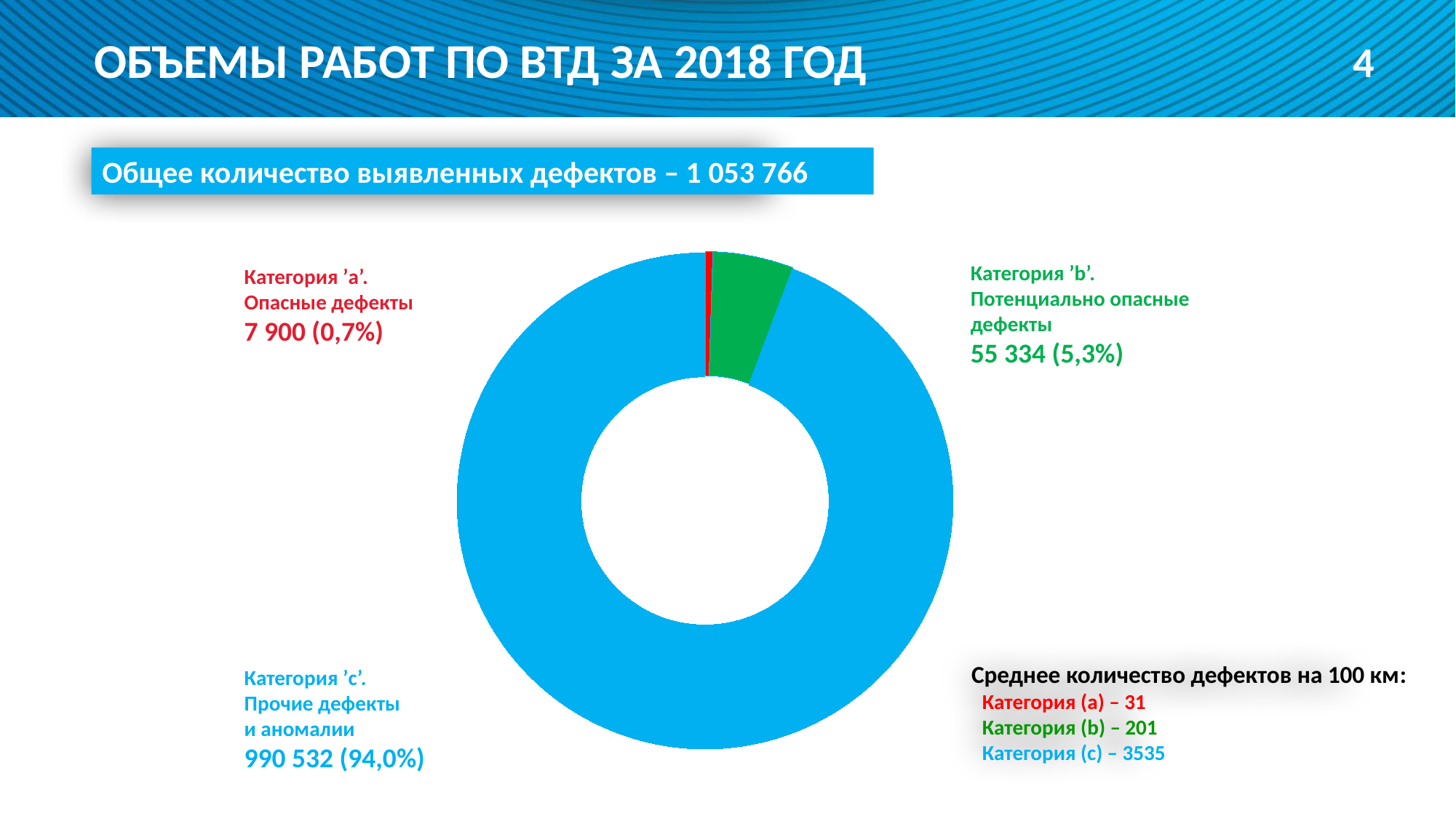
Which category has the largest slice of the chart? Категория 'c' What is the number of defects for Категория 'c' (Прочие дефекты и аномалии)? 990 532 What is the difference between the values for Категория 'b' and Категория 'a'? 47 434 What colour is the slice for Категория 'b' in the chart? green What kind of chart is shown on the slide? pie chart (donut) What share of the chart does Категория 'a' represent? 0,7% Which is larger, the value for Категория 'a' or Категория 'b'? Категория 'b' What share of the chart does Категория 'c' represent? 94,0% Which category has the smallest slice of the chart? Категория 'a' What is the number of defects for Категория 'b' (Потенциально опасные дефекты)? 55 334 What is the number of defects for Категория 'a' (Опасные дефекты)? 7 900 How many categories does the chart show? 3